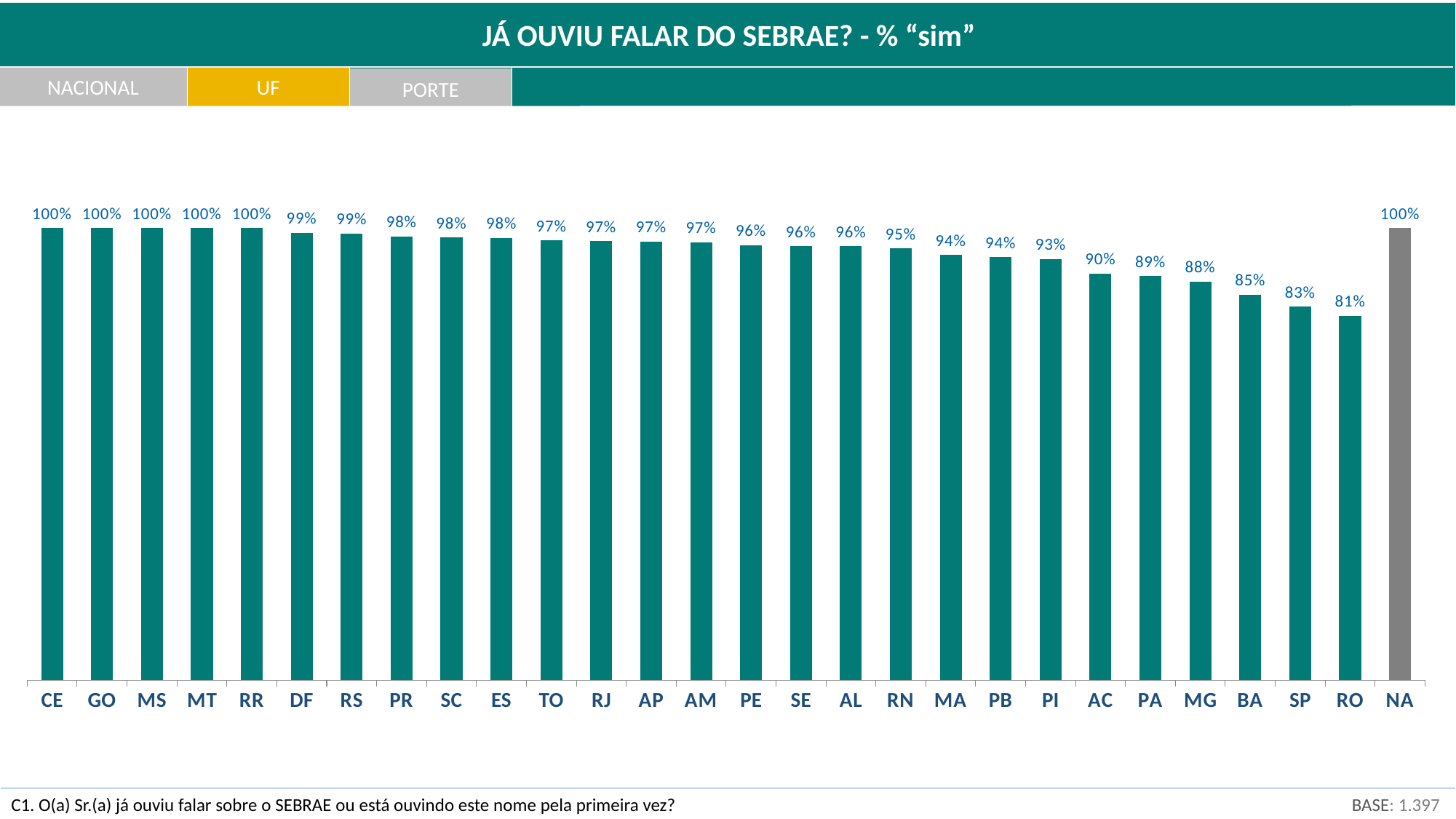
What kind of chart is shown on the slide? bar chart Which category has the lowest value? RO What is the difference between the values for CE and RO? 19% What is the value for PI? 93% How many categories are shown on the x axis? 28 Which is larger, the value for PA or the value for SP? PA What is the value for SP? 83% What is the title of the chart? JÁ OUVIU FALAR DO SEBRAE? - % "sim" Which is larger, the value for RN or the value for AC? RN What is the difference between the values for MG and BA? 3% What is the value for AC? 90% What is the value for NA? 100%